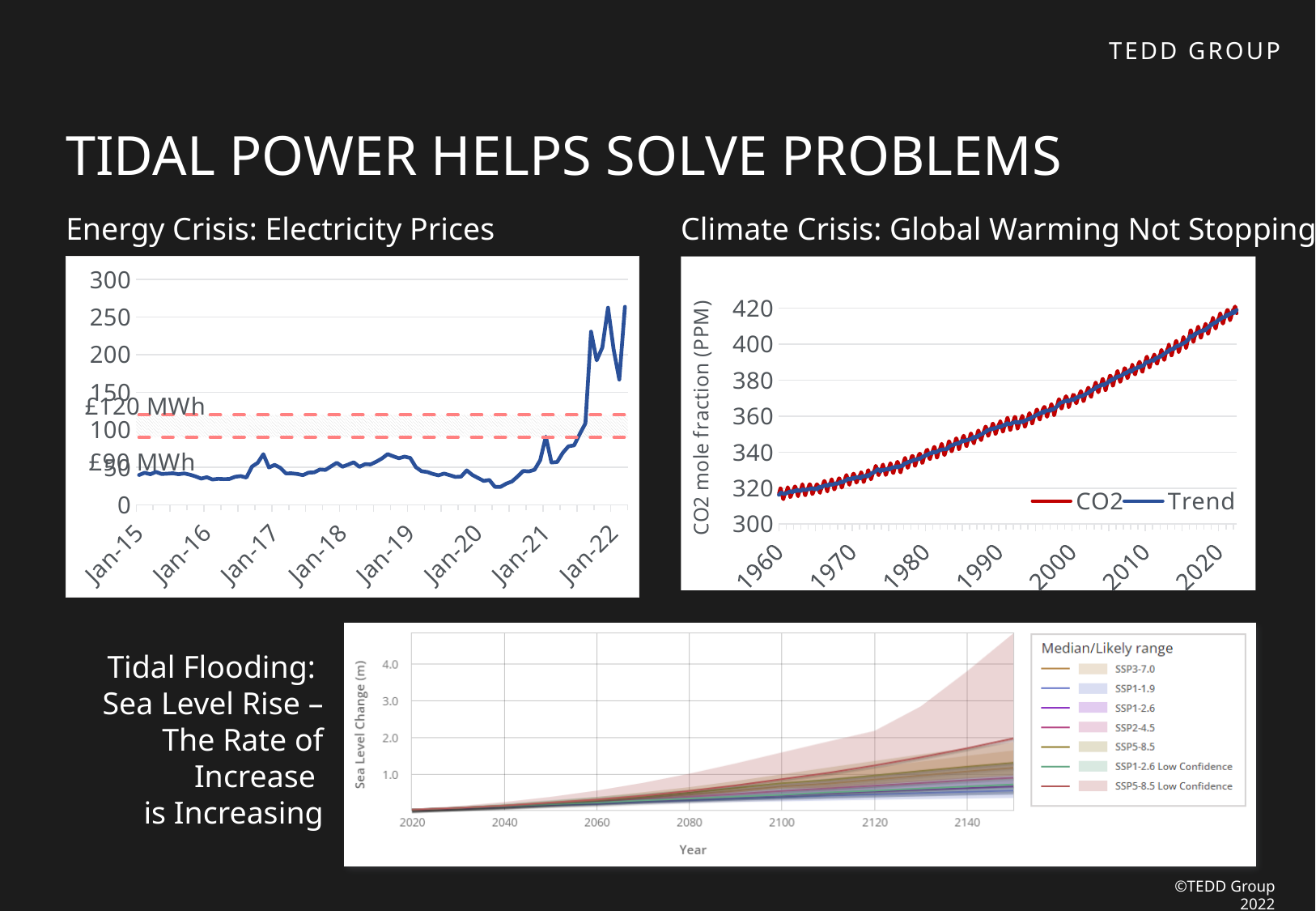
What is the vertical axis label of the 'Climate Crisis: Global Warming Not Stopping' chart? CO2 mole fraction (PPM) In the 'Climate Crisis: Global Warming Not Stopping' chart, do the CO2 values rise or fall from 1960 to 2020? rise In the 'Energy Crisis: Electricity Prices' chart, is the value at Jan-20 greater or less than 100? less In the 'Energy Crisis: Electricity Prices' chart, what is the highest value shown on the vertical axis? 300 In the 'Energy Crisis: Electricity Prices' chart, which is larger, the value at Jan-22 or the value at Jan-16? Jan-22 In the 'Climate Crisis: Global Warming Not Stopping' chart, is the CO2 value in 1960 greater or less than 340? less What kind of chart is the 'Energy Crisis: Electricity Prices' chart? line chart In the 'Climate Crisis: Global Warming Not Stopping' chart, is the CO2 value in 2020 greater or less than 400? greater In the sea level chart at the bottom of the slide, do the median sea level change values rise or fall from 2020 to 2140? rise How many entries does the legend of the sea level chart at the bottom of the slide list? 7 How many series does the legend of the 'Climate Crisis: Global Warming Not Stopping' chart list? 2